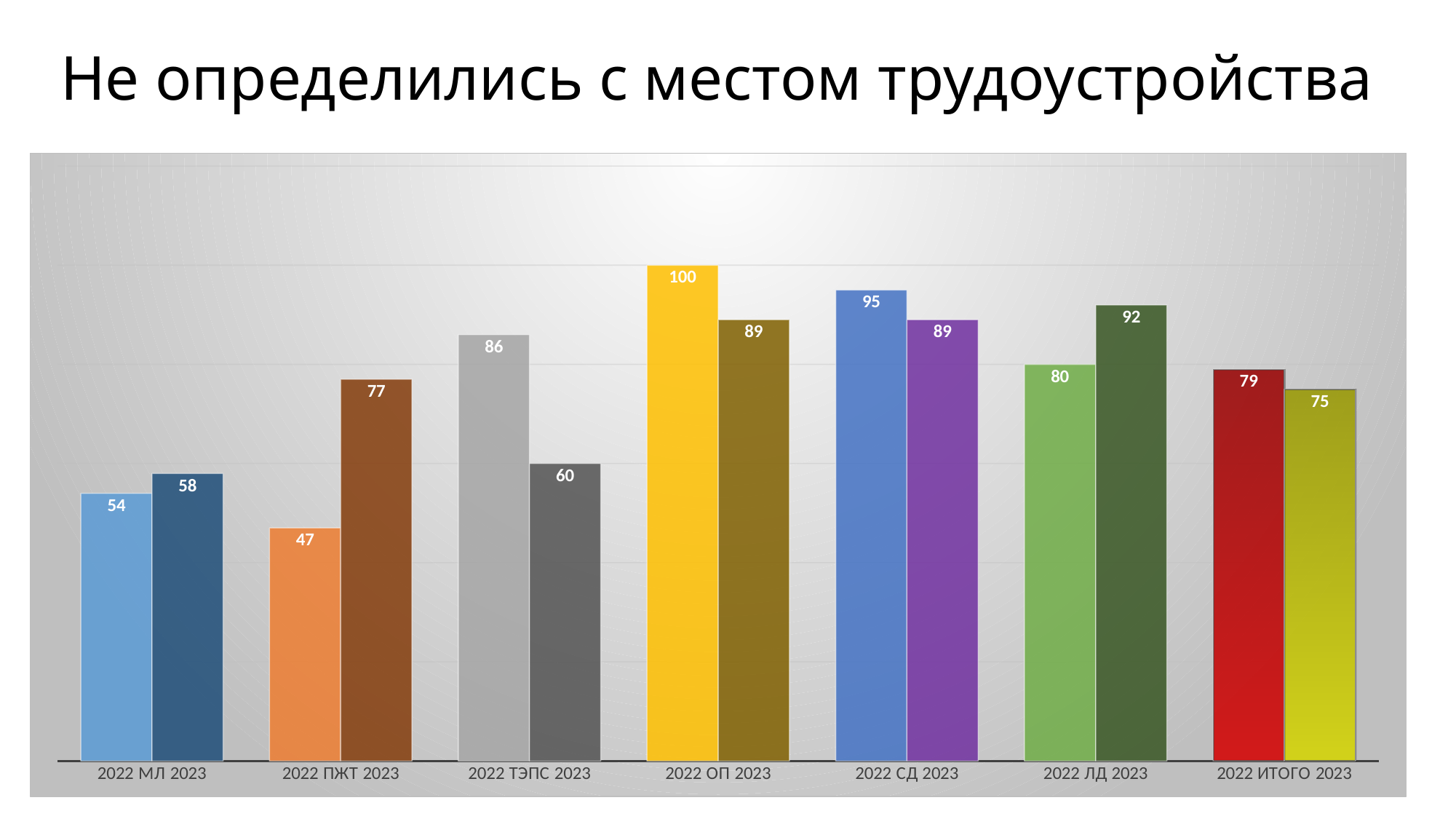
What is the 2022 value for ТЭПС? 86 How many categories are shown on the x axis? 7 Which category has the lowest 2023 value? МЛ What is the difference between the 2022 and 2023 values for ПЖТ? 30 What is the 2023 value for ПЖТ? 77 What is the 2022 value for ОП? 100 Which is larger for ЛД: the 2022 value or the 2023 value? 2023 What is the difference between the 2022 and 2023 values for ТЭПС? 26 Which category has the lowest 2022 value? ПЖТ Which category has the highest 2022 value? ОП What is the 2023 value for ИТОГО? 75 What type of chart is shown on the slide? Bar chart